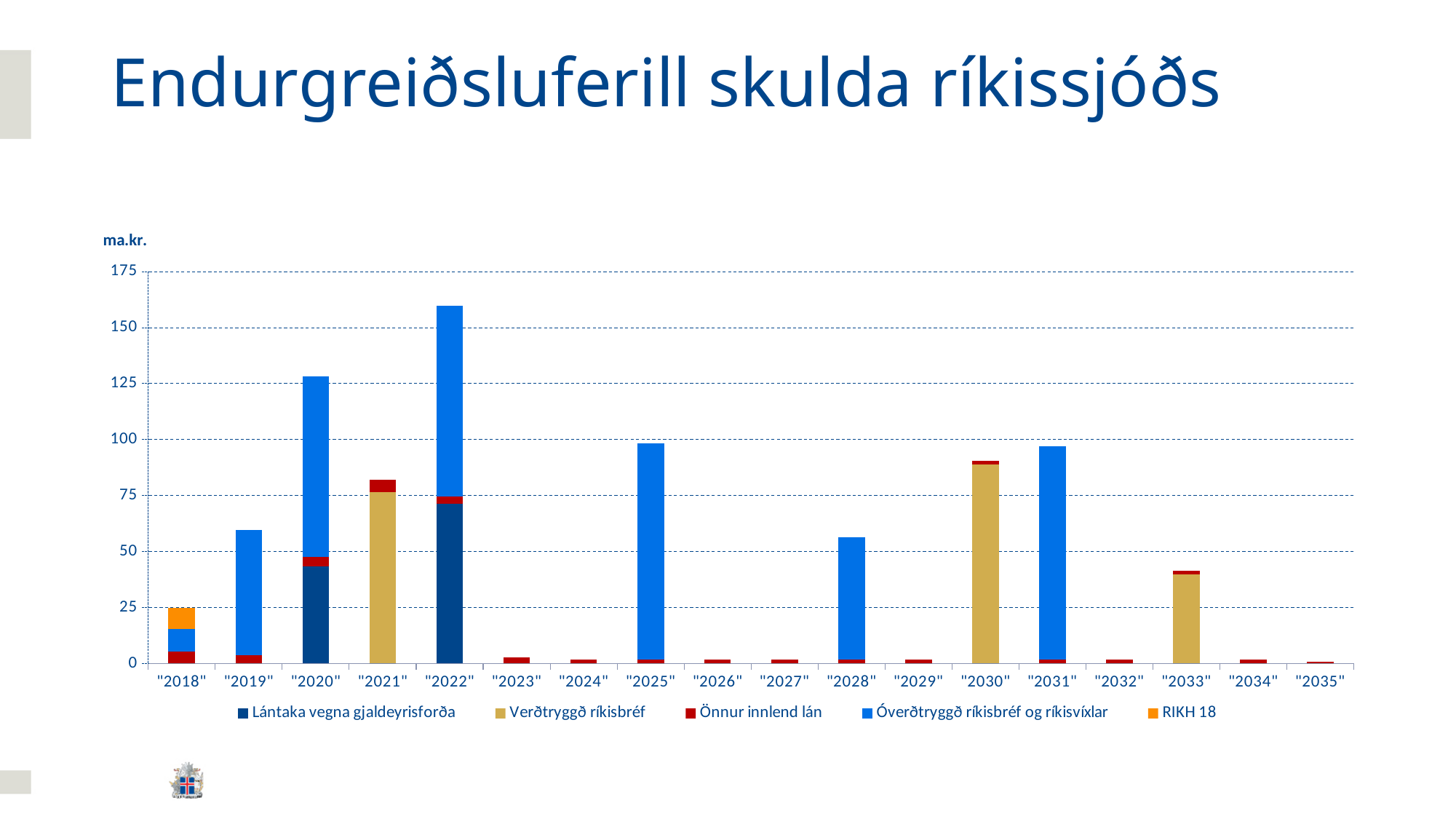
What unit is shown above the y axis of the chart? ma.kr. Which year has the larger total bar, 2020 or 2025? 2020 Is the total value for 2020 greater or less than 125? greater How many series does the legend list? 5 How many years are shown on the x axis of the chart? 18 Which year has the larger total bar, 2030 or 2033? 2030 Is the total value for 2022 greater or less than 150? greater Is the total value for 2033 greater or less than 50? less What kind of chart is shown on the slide? stacked bar chart Which year has the tallest bar in the chart? 2022